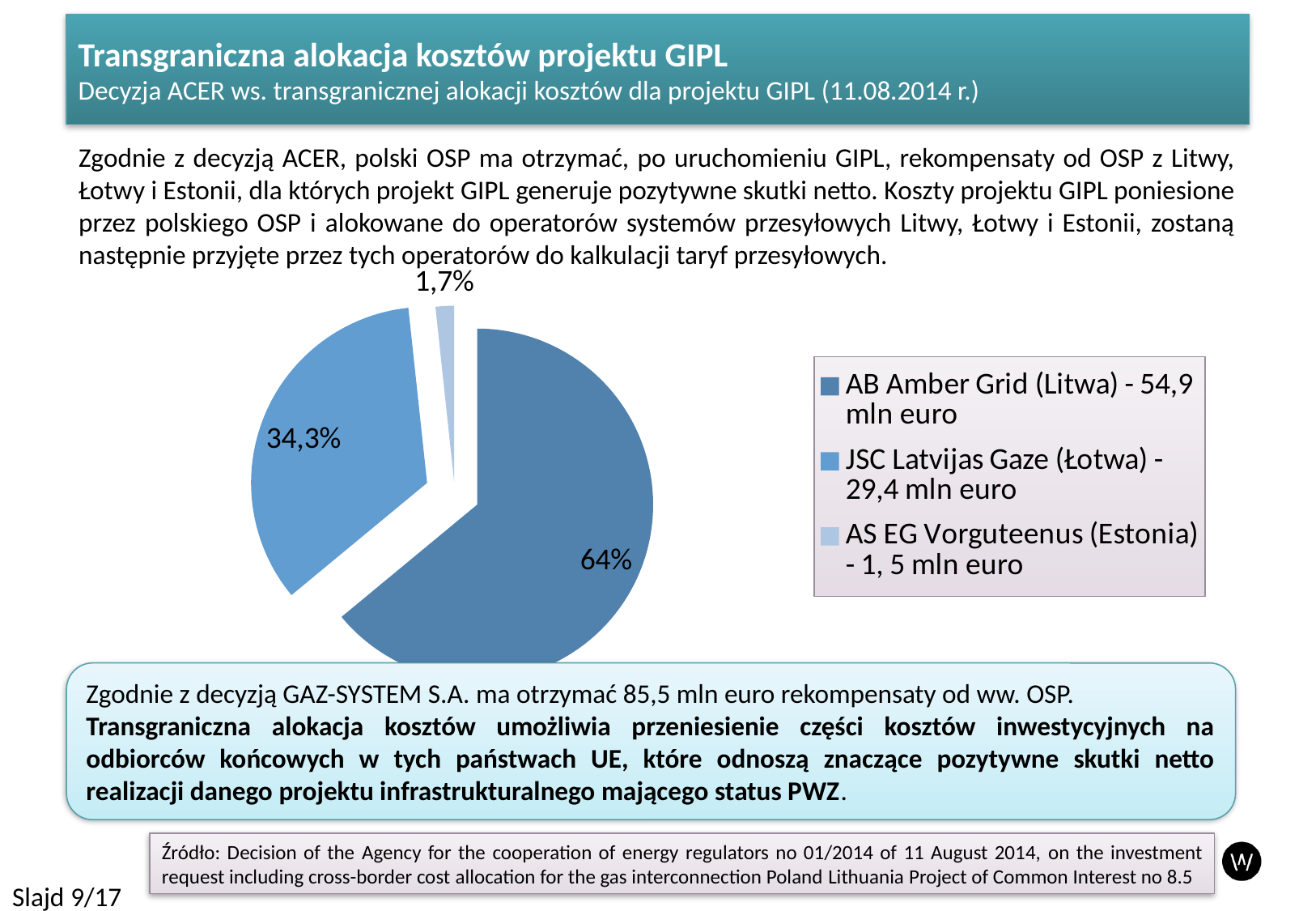
How many entries does the legend of the pie chart list? 3 What kind of chart is shown on the slide? pie chart What share of the pie does JSC Latvijas Gaze (Łotwa) have? 34,3% According to the legend, what amount in mln euro is given for AB Amber Grid (Litwa)? 54,9 mln euro According to the legend, what amount in mln euro is given for JSC Latvijas Gaze (Łotwa)? 29,4 mln euro What is the difference in percentage points between the AB Amber Grid (Litwa) slice and the JSC Latvijas Gaze (Łotwa) slice? 29,7 Which entity has the largest slice of the pie? AB Amber Grid (Litwa) What share of the pie does AS EG Vorguteenus (Estonia) have? 1,7% Which slice is larger: JSC Latvijas Gaze (Łotwa) or AS EG Vorguteenus (Estonia)? JSC Latvijas Gaze (Łotwa) Which entity has the smallest slice of the pie? AS EG Vorguteenus (Estonia) How many slices does the pie chart have? 3 What share of the pie does AB Amber Grid (Litwa) have? 64%